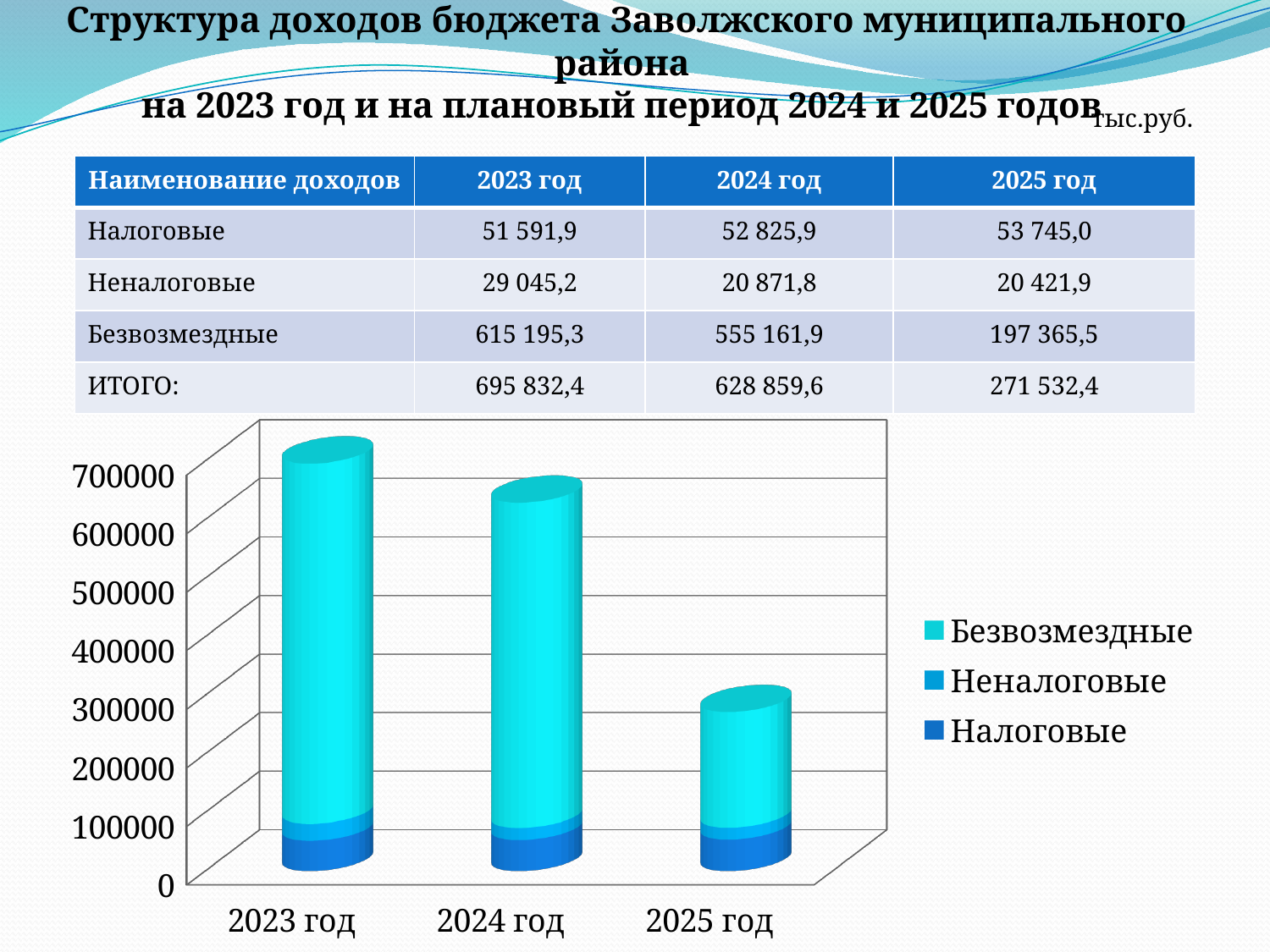
Which series is listed first (at the top) in the chart legend? Безвозмездные According to the table, what is the value of Безвозмездные for 2023 год? 615 195,3 Is the total bar for 2023 год greater or less than 600000? greater Is the total bar for 2025 год greater or less than 300000? less Which year has the tallest bar in the chart? 2023 год Which bar is taller, 2024 год or 2025 год? 2024 год Which year has the shortest bar in the chart? 2025 год What kind of chart is shown on the slide? Stacked bar chart How many year categories are shown on the x axis of the chart? 3 Do the total bar heights rise or fall from 2023 год to 2025 год? Fall According to the table, what is the ИТОГО value for 2025 год? 271 532,4 How many series does the chart legend list? 3